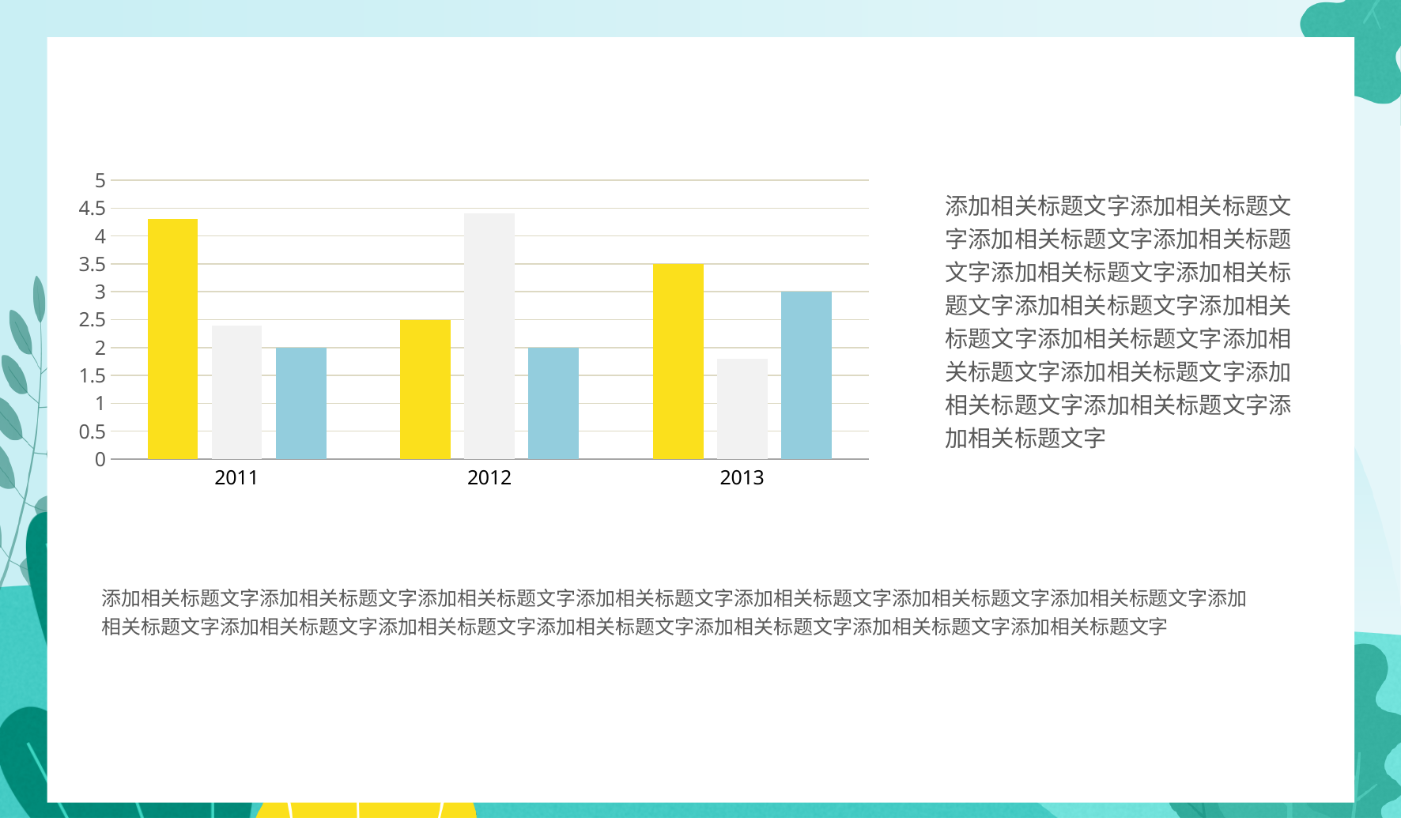
How many categories (years) are shown on the x axis of the chart? 3 What is the difference between the yellow bar and the blue bar for 2013? 0.5 Is the value of the grey bar for 2013 greater or less than 2? less What kind of chart is shown on the slide? bar chart What is the value of the blue bar for 2013? 3 In 2011, which is larger: the yellow bar or the grey bar? the yellow bar What is the value of the blue bar for 2011? 2 What is the value of the yellow bar for 2013? 3.5 In which year is the yellow bar the tallest? 2011 Is the value of the grey bar for 2012 greater or less than 4? greater Is the value of the yellow bar for 2011 greater or less than 4? greater What is the value of the yellow bar for 2012? 2.5